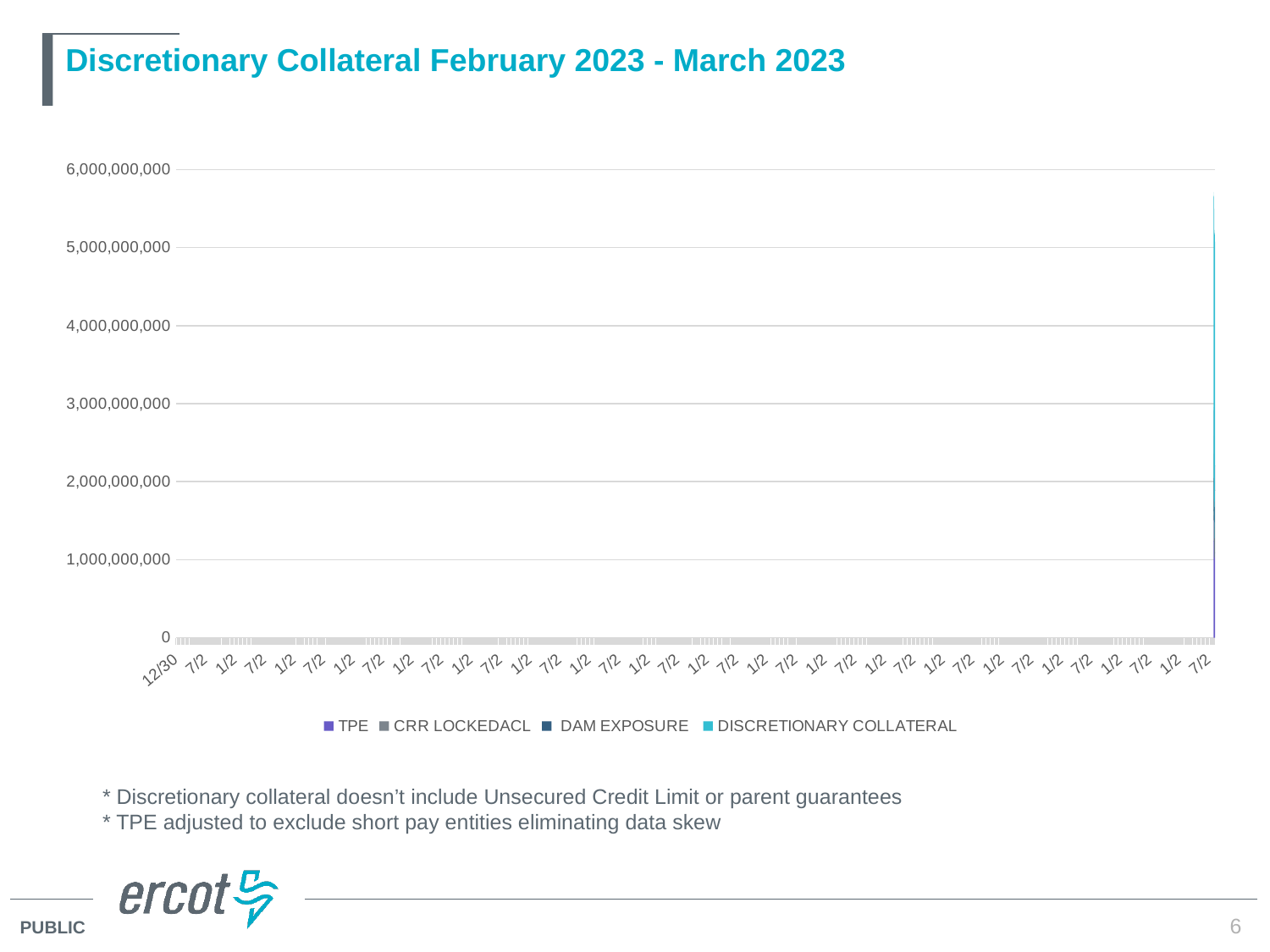
Is the total height of the tallest stacked bar (at the far right) greater or less than 5,000,000,000? greater What is the lowest value labelled on the vertical axis? 0 How many series does the legend list? 4 Which series is listed last in the legend? DISCRETIONARY COLLATERAL Where along the horizontal axis is the tallest stacked bar located: at the left end or the right end? right end What is the first date label shown on the horizontal axis? 12/30 Is the total height of the tallest stacked bar (at the far right) greater or less than 6,000,000,000? less What is the title of the slide's chart? Discretionary Collateral February 2023 - March 2023 What is the highest value labelled on the vertical axis? 6,000,000,000 What kind of chart is shown on the slide? area chart